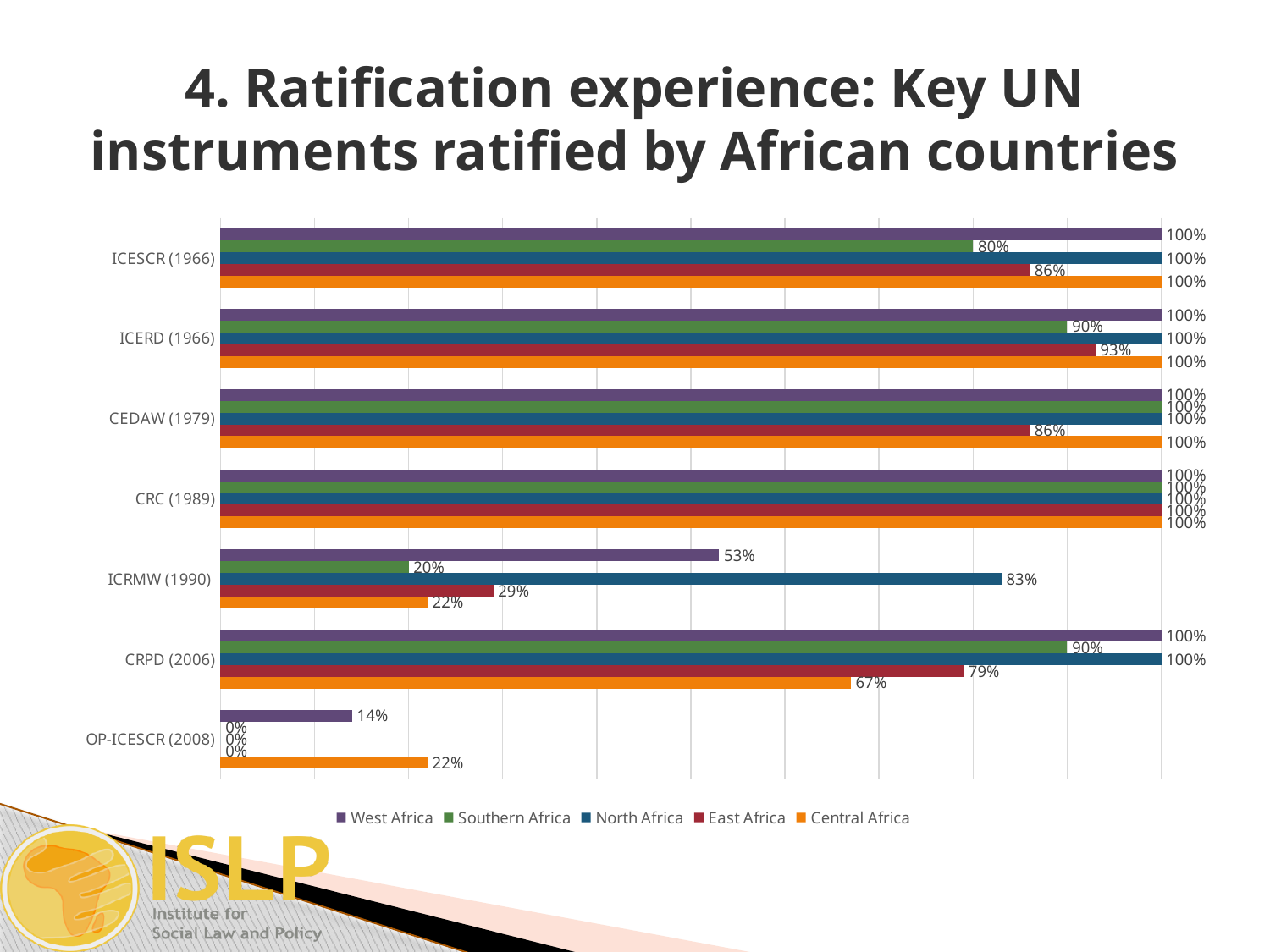
What kind of chart is shown on the slide? Bar chart Which region has the highest value for OP-ICESCR (2008)? Central Africa What is the value for Central Africa for CRPD (2006)? 67% How many UN instruments (categories) are shown on the chart? 7 What is the value for East Africa for ICERD (1966)? 93% What is the value for North Africa for ICRMW (1990)? 83% For CRPD (2006), which is larger: the East Africa value or the Central Africa value? East Africa Which region has the lowest value for ICRMW (1990)? Southern Africa Which series is shown in orange in the legend? Central Africa How many series does the legend list? 5 What is the difference between the West Africa and Southern Africa values for ICRMW (1990)? 33% What is the value for Southern Africa for ICESCR (1966)? 80%